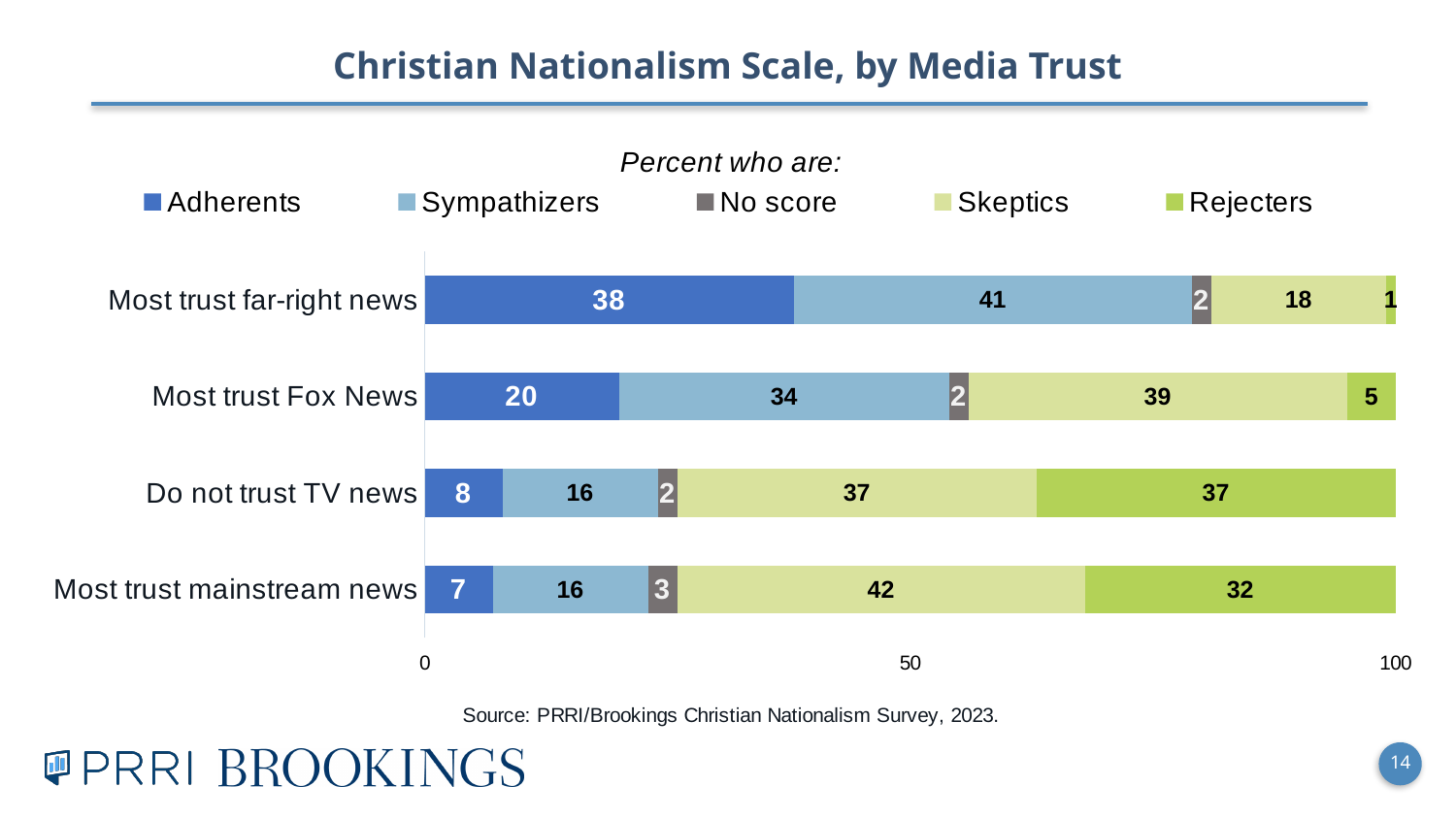
Which media trust group has the lowest share of Rejecters? Most trust far-right news How much larger is the Sympathizers value for 'Most trust far-right news' than for 'Most trust Fox News'? 7 What kind of chart is shown on the slide? Stacked bar chart How many series does the legend list? 5 How many media trust categories are shown on the chart? 4 What is the Skeptics value for the 'Most trust Fox News' bar? 39 What percentage of those who most trust far-right news are Adherents? 38 Which media trust group has the highest share of Adherents? Most trust far-right news Which has a larger Skeptics value: 'Do not trust TV news' or 'Most trust mainstream news'? Most trust mainstream news What is the Rejecters value for 'Most trust mainstream news'? 32 What is the title of the chart? Percent who are: What is the total of the stacked bar for 'Most trust Fox News'? 100